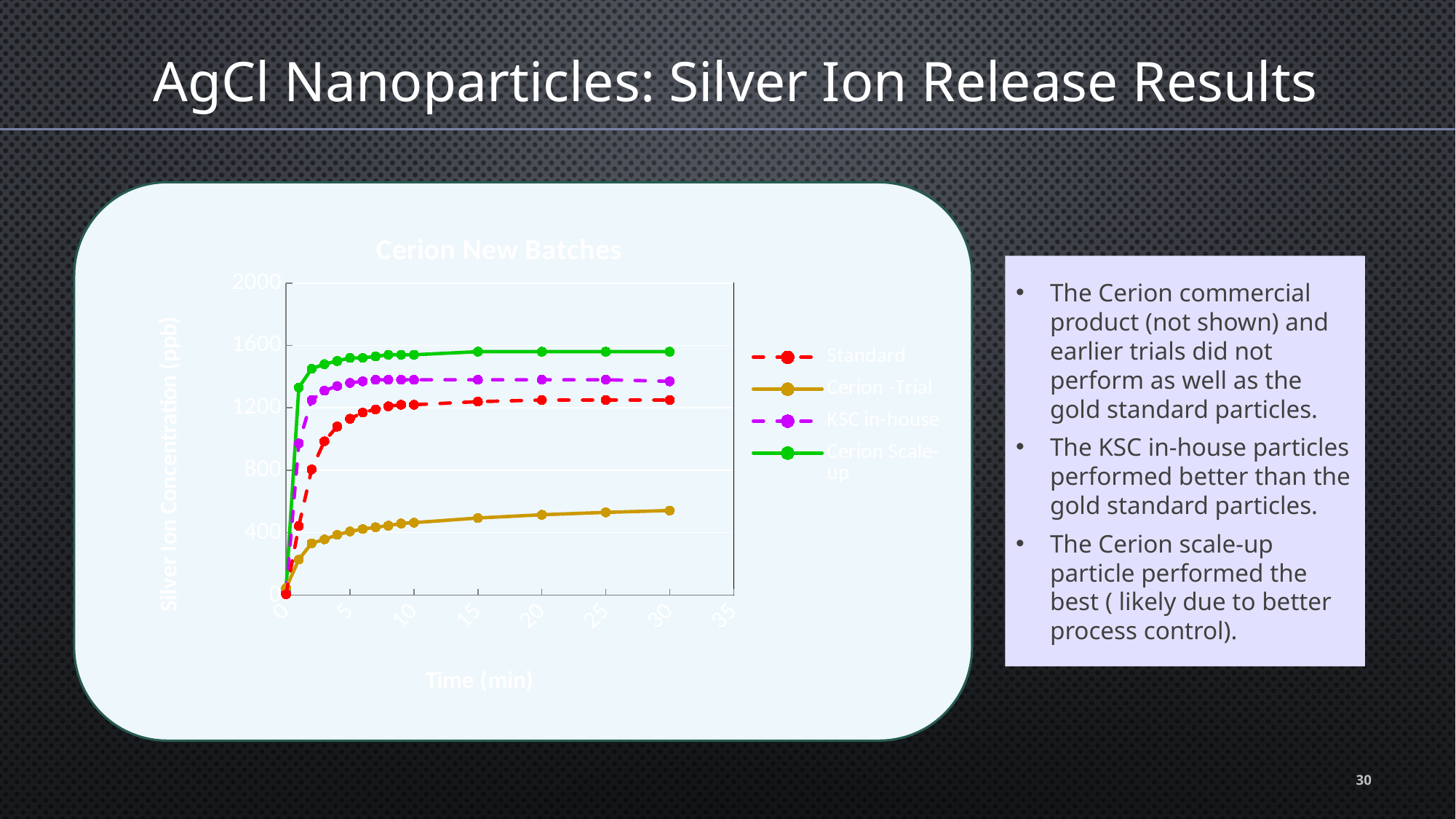
Which series reaches the highest silver ion concentration? Cerion Scale-up How many series does the chart legend list? 4 Is the value for Cerion Scale-up at 30 minutes greater or less than 1200? greater Which series has the lowest silver ion concentration at 30 minutes? Cerion -Trial Is the value for Standard at 30 minutes greater or less than 1600? less Does the Cerion -Trial series rise or fall as time increases? Rises What is the title of the chart? Cerion New Batches What type of chart is shown on the slide? Line chart At 30 minutes, which series has the higher value: KSC in-house or Standard? KSC in-house Is the value for KSC in-house at 30 minutes greater or less than 1200? greater What is the label of the y axis of the chart? Silver Ion Concentration (ppb)